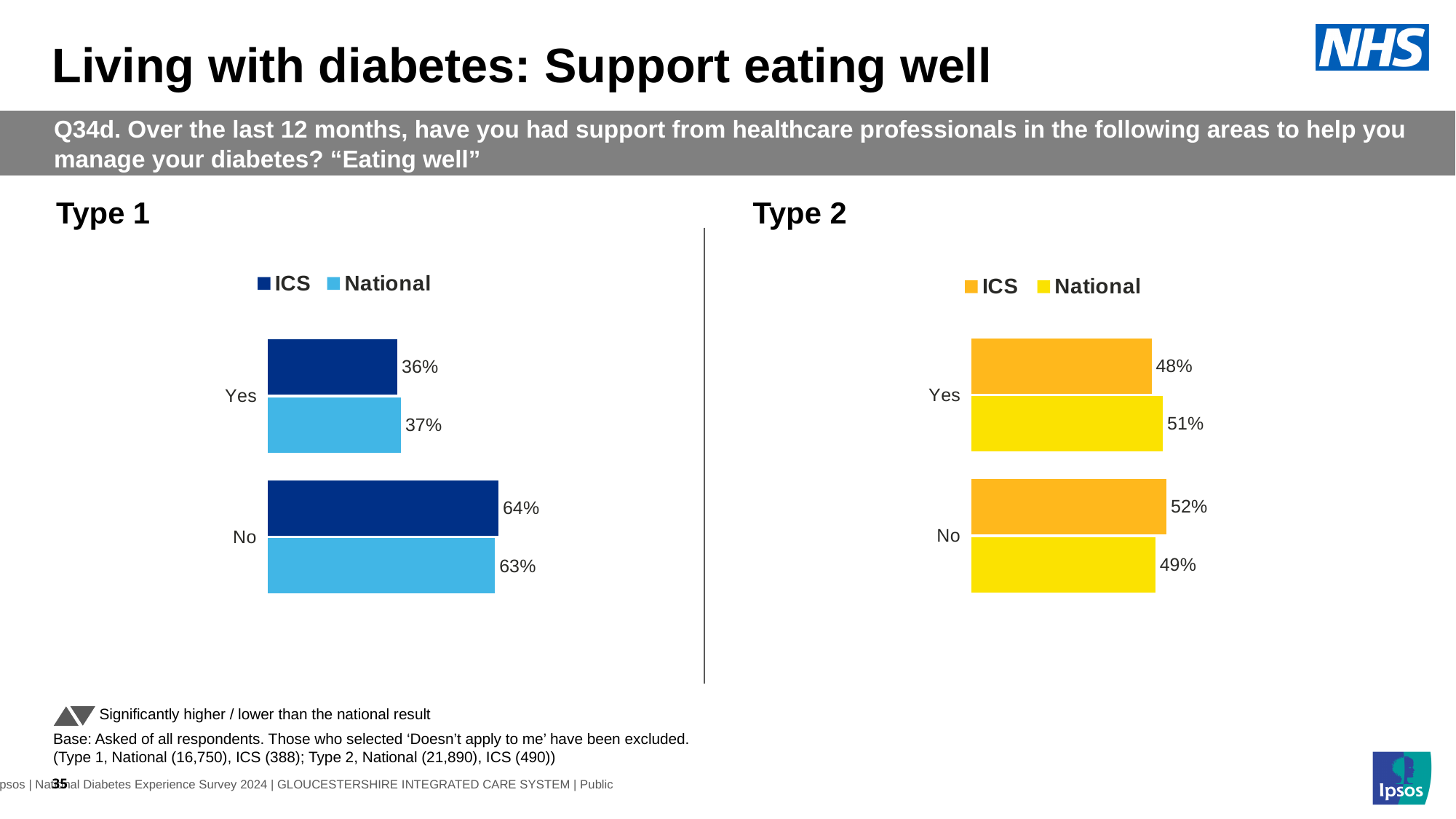
In the Type 1 chart, what is the ICS value for Yes? 36% How many series does the legend of the Type 1 chart list? 2 In the Type 1 chart, which category has the highest ICS value? No What kind of chart is the Type 1 chart? Bar chart In the Type 1 chart, what is the National value for No? 63% In the Type 2 chart, what is the National value for No? 49% In the Type 2 chart, which is larger for Yes: ICS or National? National In the Type 2 chart, which category has the lowest ICS value? Yes In the Type 1 chart, what is the difference between the ICS values for No and Yes? 28 percentage points In the Type 2 chart, what is the ICS value for Yes? 48% How many categories are shown in the Type 2 chart? 2 In the Type 2 chart, what is the difference between the National values for Yes and No? 2 percentage points